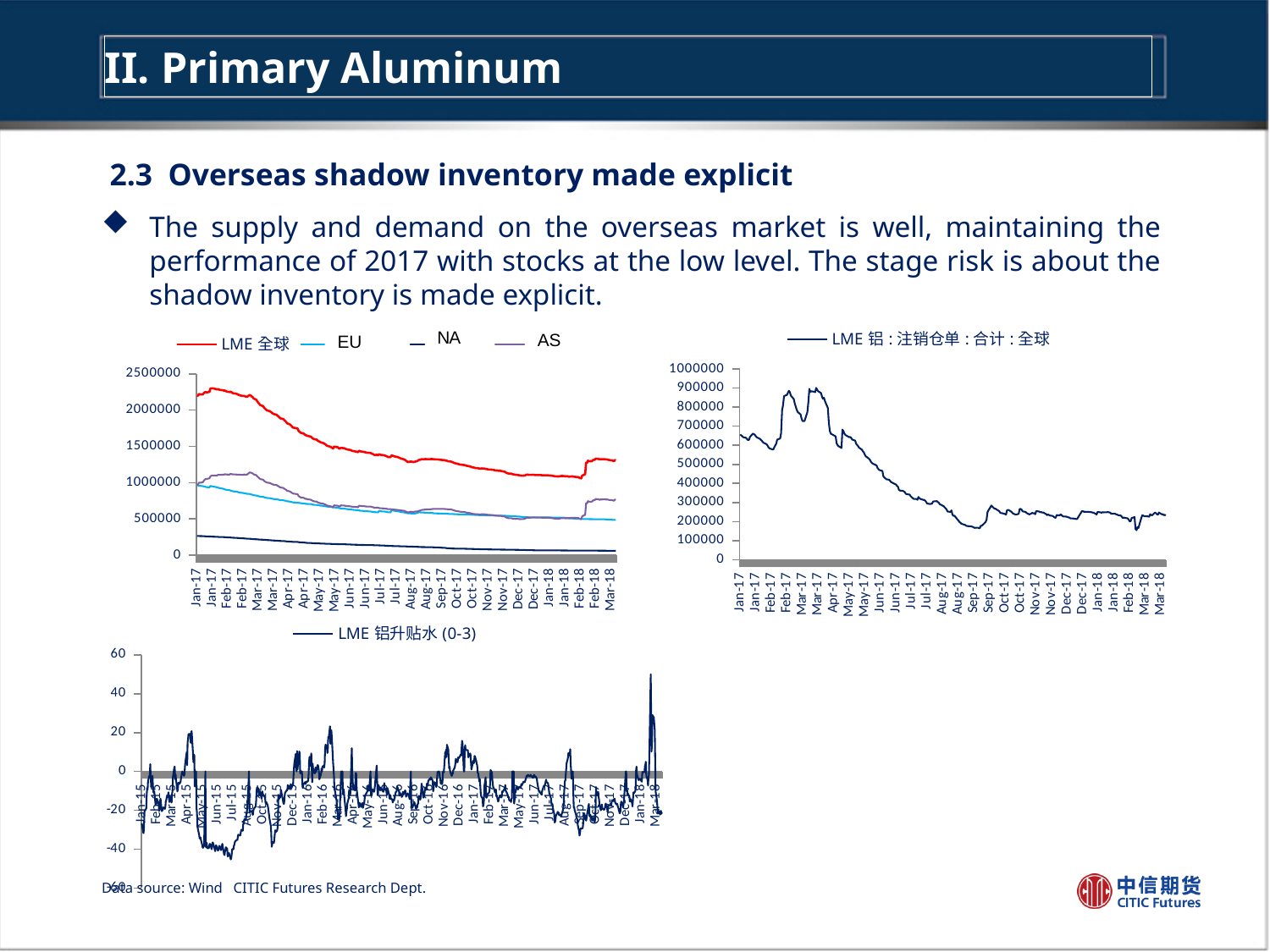
In the top-left chart, which series has the highest values throughout the period? LME 全球 In the top-right chart (LME 铝:注销仓单:合计:全球), does the series rise or fall overall from Jan-17 to Mar-18? fall In the top-left chart, does the LME 全球 series rise or fall overall from Jan-17 to Mar-18? fall In the top-left chart, which series has the lowest values throughout the period? NA In the top-left chart, how many series does the legend list? 4 In the bottom-left chart (LME 铝升贴水 (0-3)), is the highest value reached in early 2018 greater or less than 40? greater In the top-right chart (LME 铝:注销仓单:合计:全球), is the value in Mar-18 greater or less than 300000? less In the top-left chart, is the value of LME 全球 in Mar-18 greater or less than 1500000? less What kind of chart is the top-left chart with LME 全球, EU, NA and AS? line chart